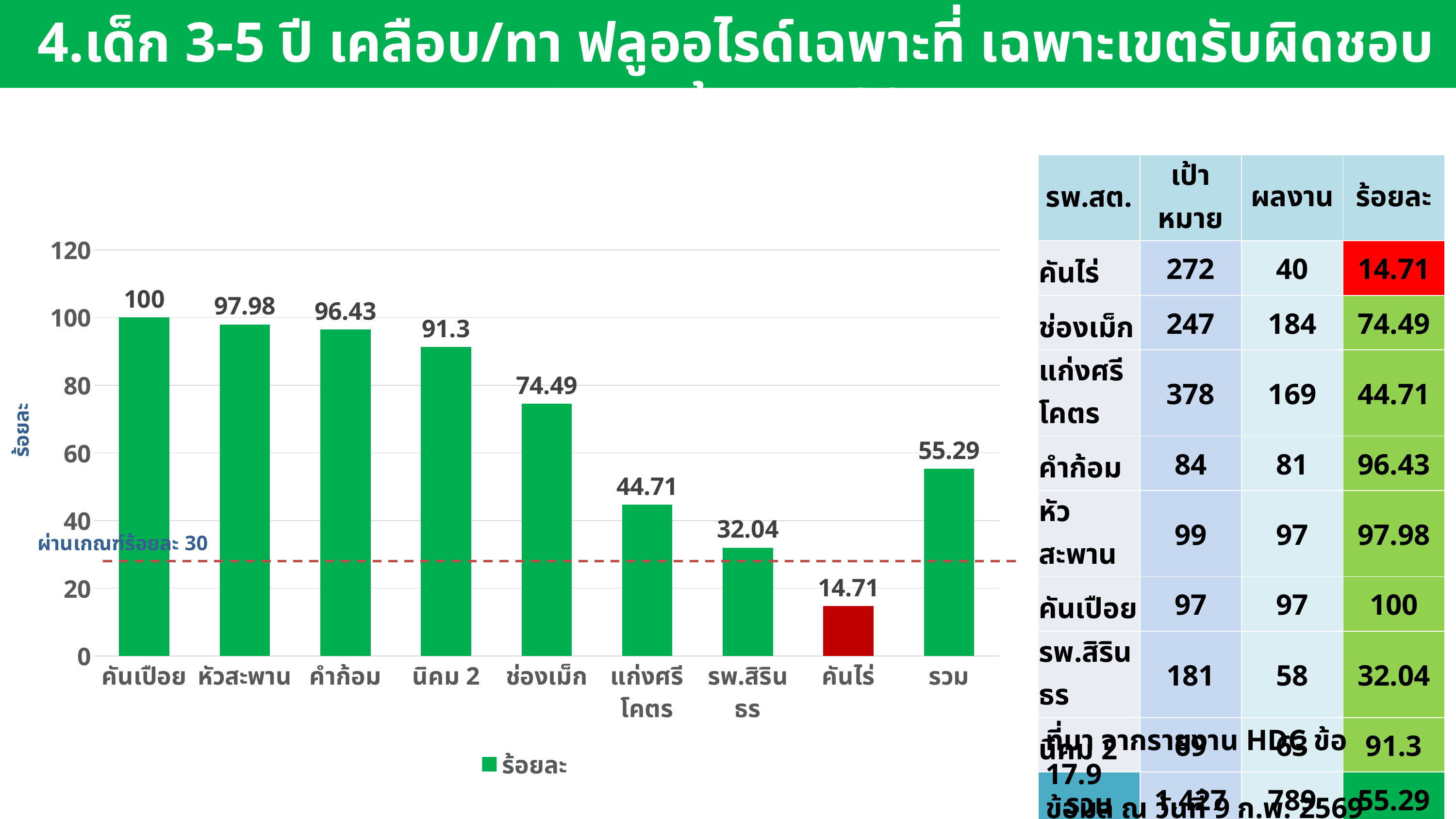
Which is larger, the value for แก่งศรีโคตร or the value for รพ.สิรินธร? แก่งศรีโคตร What is the value for ช่องเม็ก in the bar chart? 74.49 What is the difference between the values for หัวสะพาน and คำก้อม? 1.55 Which category has the lowest value in the bar chart? คันไร่ How many categories are shown on the x axis of the bar chart? 9 What kind of chart is shown on the slide? bar chart Is the value for นิคม 2 greater or less than 80? greater How many series does the legend of the bar chart list? 1 What is the value for รวม in the bar chart? 55.29 What colour is the bar for คันไร่ in the bar chart? red Which category has the highest value in the bar chart? คันเปือย What is the value for คันเปือย in the bar chart? 100